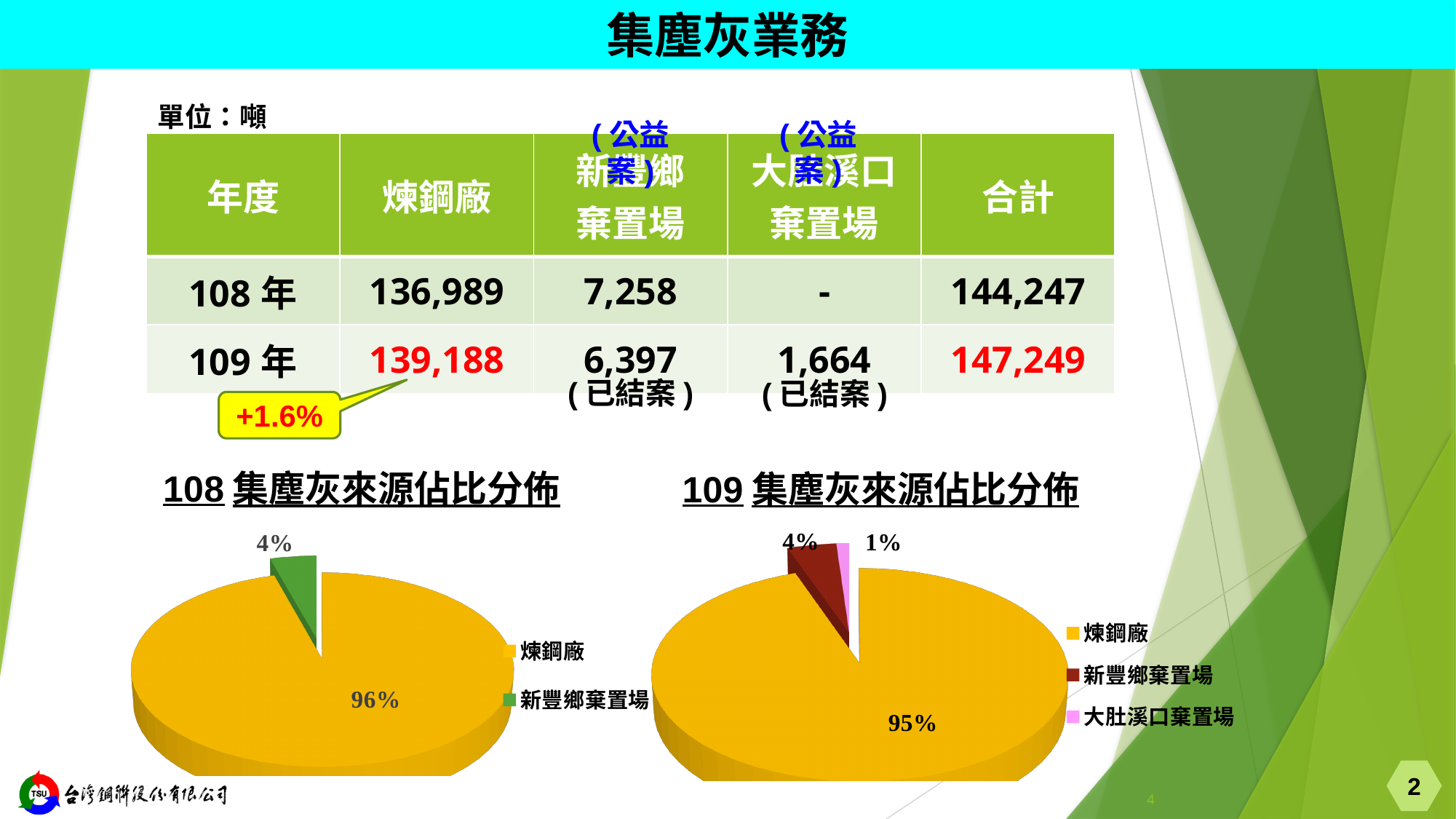
In the right chart (109 集塵灰來源佔比分佈), what share does 大肚溪口棄置場 have? 1% In the right chart (109 集塵灰來源佔比分佈), which category has the smallest share? 大肚溪口棄置場 What kind of chart is the left chart titled 108 集塵灰來源佔比分佈? pie chart In the right chart (109 集塵灰來源佔比分佈), which colour represents 大肚溪口棄置場? pink In the left chart (108 集塵灰來源佔比分佈), what share does 煉鋼廠 have? 96% How many slices does the left chart (108 集塵灰來源佔比分佈) have? 2 In the right chart (109 集塵灰來源佔比分佈), what share does 煉鋼廠 have? 95% In the right chart (109 集塵灰來源佔比分佈), what is the difference in percentage points between the 新豐鄉棄置場 share and the 大肚溪口棄置場 share? 3% In the right chart (109 集塵灰來源佔比分佈), which category has the largest share? 煉鋼廠 How many categories does the legend of the right chart (109 集塵灰來源佔比分佈) list? 3